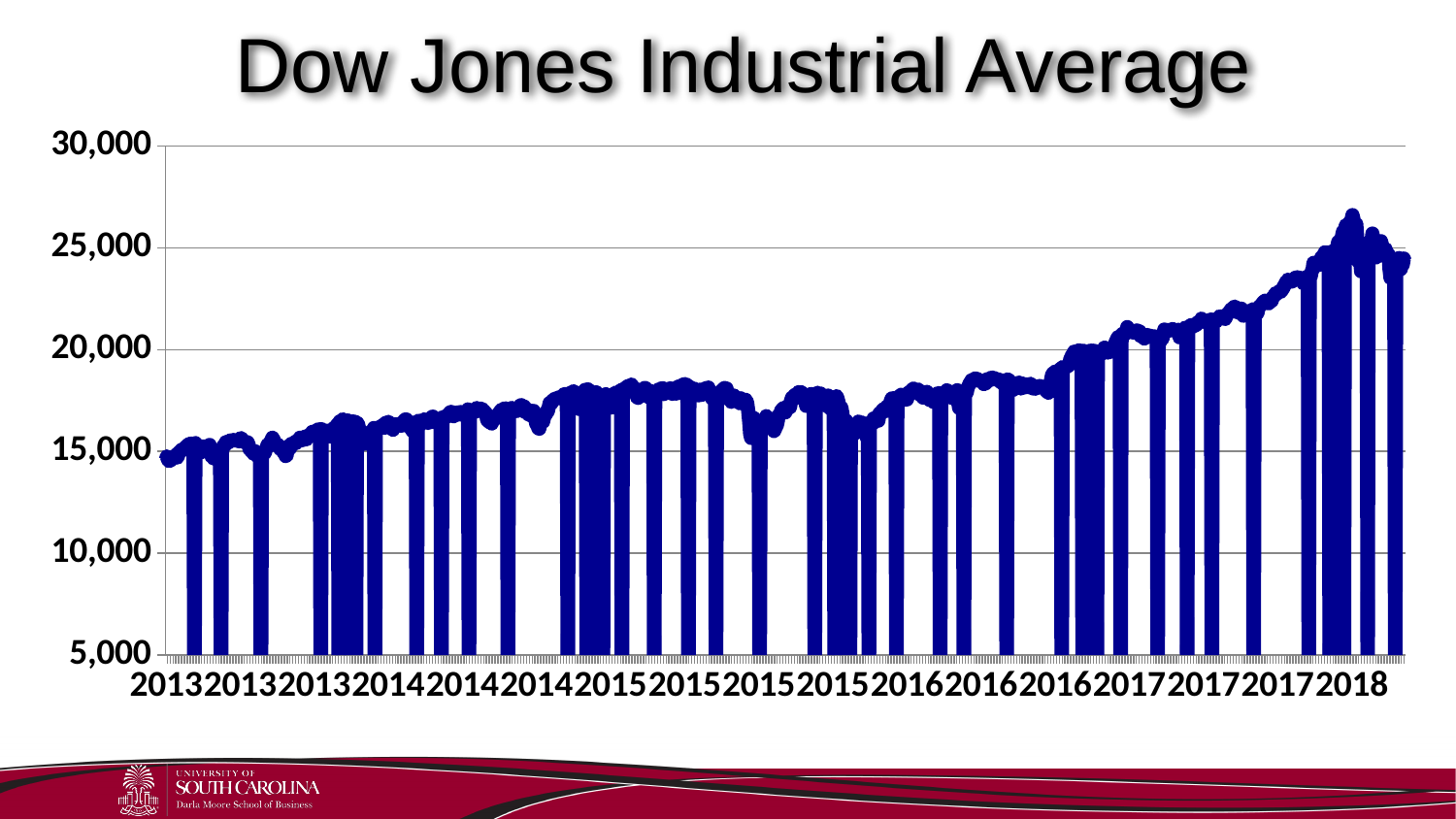
What is the title of the chart? Dow Jones Industrial Average In which year does the Dow Jones Industrial Average reach its highest value on the chart? 2018 What kind of chart is shown on the slide? line chart Do the values generally rise or fall from 2013 to 2018? rise What is the highest value shown on the vertical axis? 30,000 Is the value at the end of 2018 greater or less than 20,000? greater Is the value during 2014 greater or less than 15,000? greater How many distinct years are labelled on the horizontal axis? 6 In which year does the Dow Jones Industrial Average have its lowest value on the chart? 2013 Is the value during 2016 greater or less than 20,000? less Which is higher, the value in 2017 or the value in 2015? 2017